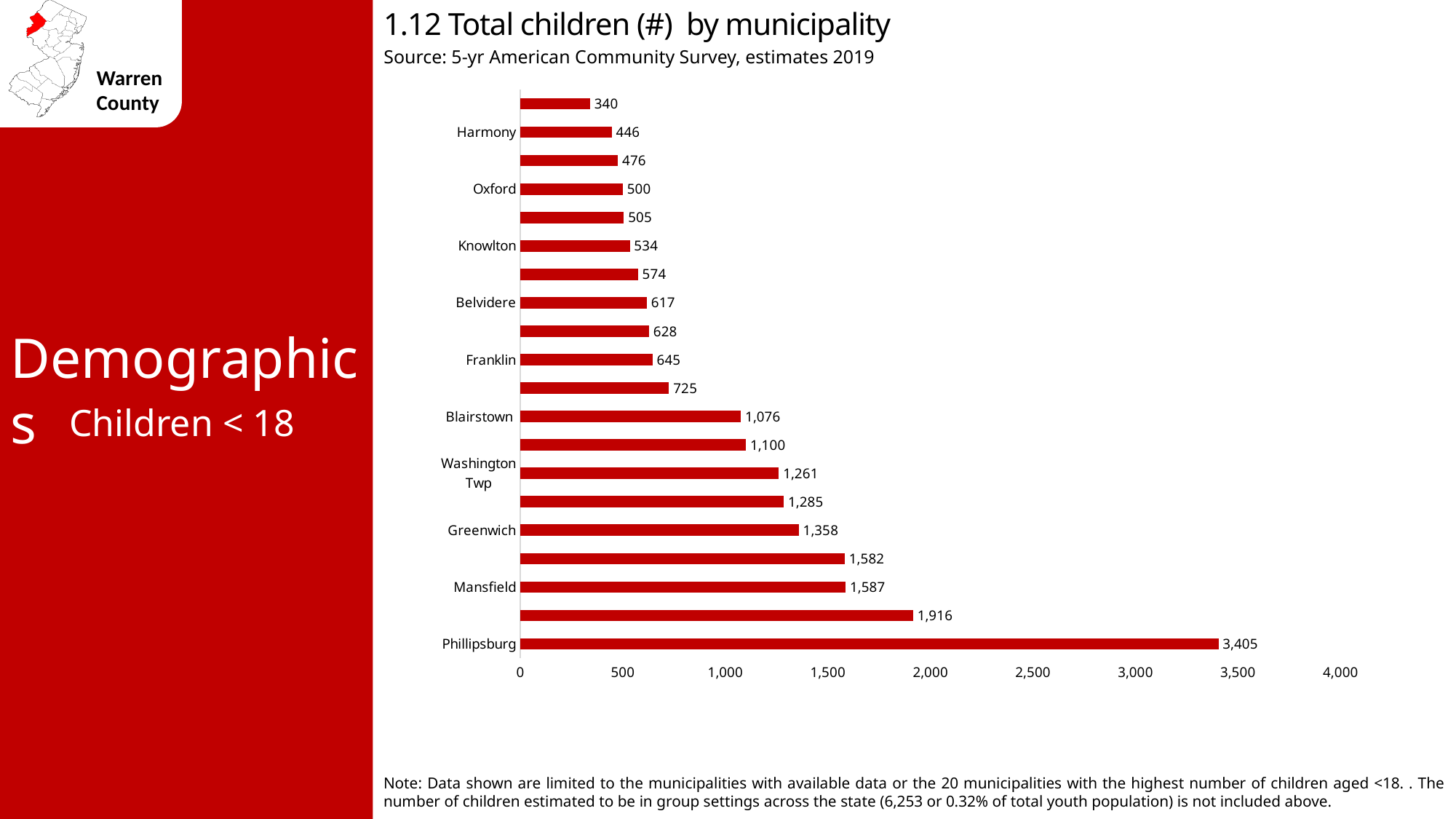
What is the smallest value labeled on the chart? 340 How many total children does the chart show for Phillipsburg? 3,405 What type of chart is shown on the slide? Bar chart What is the value shown for Harmony? 446 Which municipality has the highest number of total children? Phillipsburg How many bars are plotted on the chart? 20 What is the difference between the values for Franklin and Knowlton? 111 What is the difference between the values for Phillipsburg and Mansfield? 1,818 Which has a larger value, Greenwich or Blairstown? Greenwich What is the value shown for Washington Twp? 1,261 What is the value shown for Oxford? 500 Is the value for Belvidere greater or less than 1,000? less